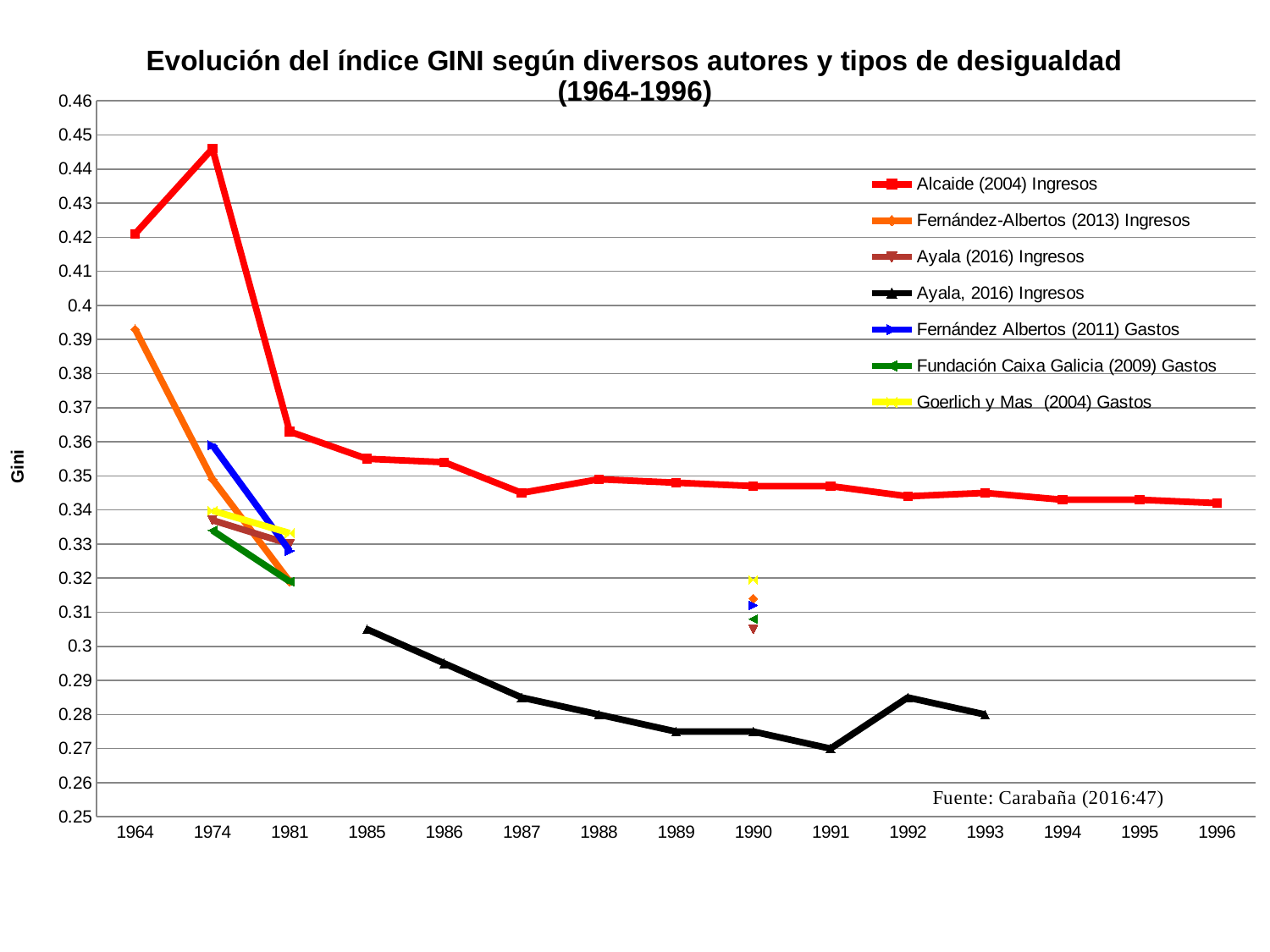
Overall, does the Alcaide (2004) Ingresos series rise or fall from 1974 to 1996? fall Is the value for Fernández-Albertos (2013) Ingresos in 1964 greater or less than 0.38? greater Is the value for Alcaide (2004) Ingresos in 1974 greater or less than 0.44? greater Is the value for Fundación Caixa Galicia (2009) Gastos in 1981 greater or less than 0.33? less What source is cited at the bottom of the chart? Carabaña (2016:47) How many years are labelled on the x axis? 15 What kind of chart is shown on the slide? line chart In which year does the Alcaide (2004) Ingresos series reach its highest value? 1974 How many series does the legend list? 7 In which year does the Ayala, 2016) Ingresos (black) series reach its lowest value? 1991 Which is larger for Alcaide (2004) Ingresos: the value in 1964 or the value in 1974? 1974